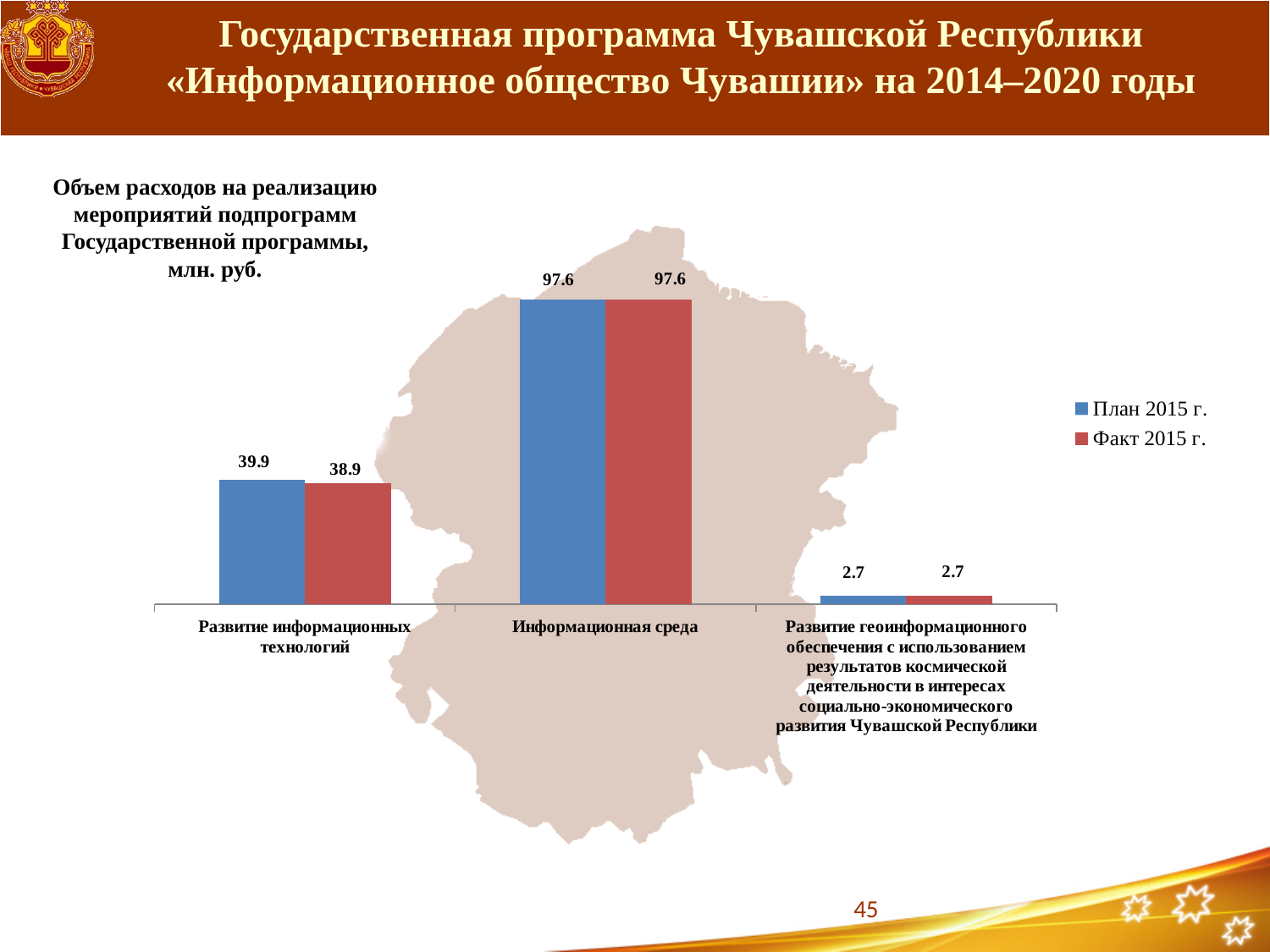
What is the Факт 2015 г. value for Развитие информационных технологий? 38.9 Which is larger for Развитие информационных технологий: the План 2015 г. value or the Факт 2015 г. value? План 2015 г. What is the Факт 2015 г. value for Развитие геоинформационного обеспечения с использованием результатов космической деятельности в интересах социально-экономического развития Чувашской Республики? 2.7 What kind of chart is shown on the slide? Bar chart What is the План 2015 г. value for Информационная среда? 97.6 Which category has the lowest Факт 2015 г. value? Развитие геоинформационного обеспечения с использованием результатов космической деятельности в интересах социально-экономического развития Чувашской Республики How many categories are shown on the x axis of the chart? 3 Which category has the highest План 2015 г. value? Информационная среда What is the difference between the План 2015 г. values for Информационная среда and Развитие информационных технологий? 57.7 How many series does the legend list? 2 What is the difference between the План 2015 г. and Факт 2015 г. values for Развитие информационных технологий? 1.0 What is the План 2015 г. value for Развитие информационных технологий? 39.9